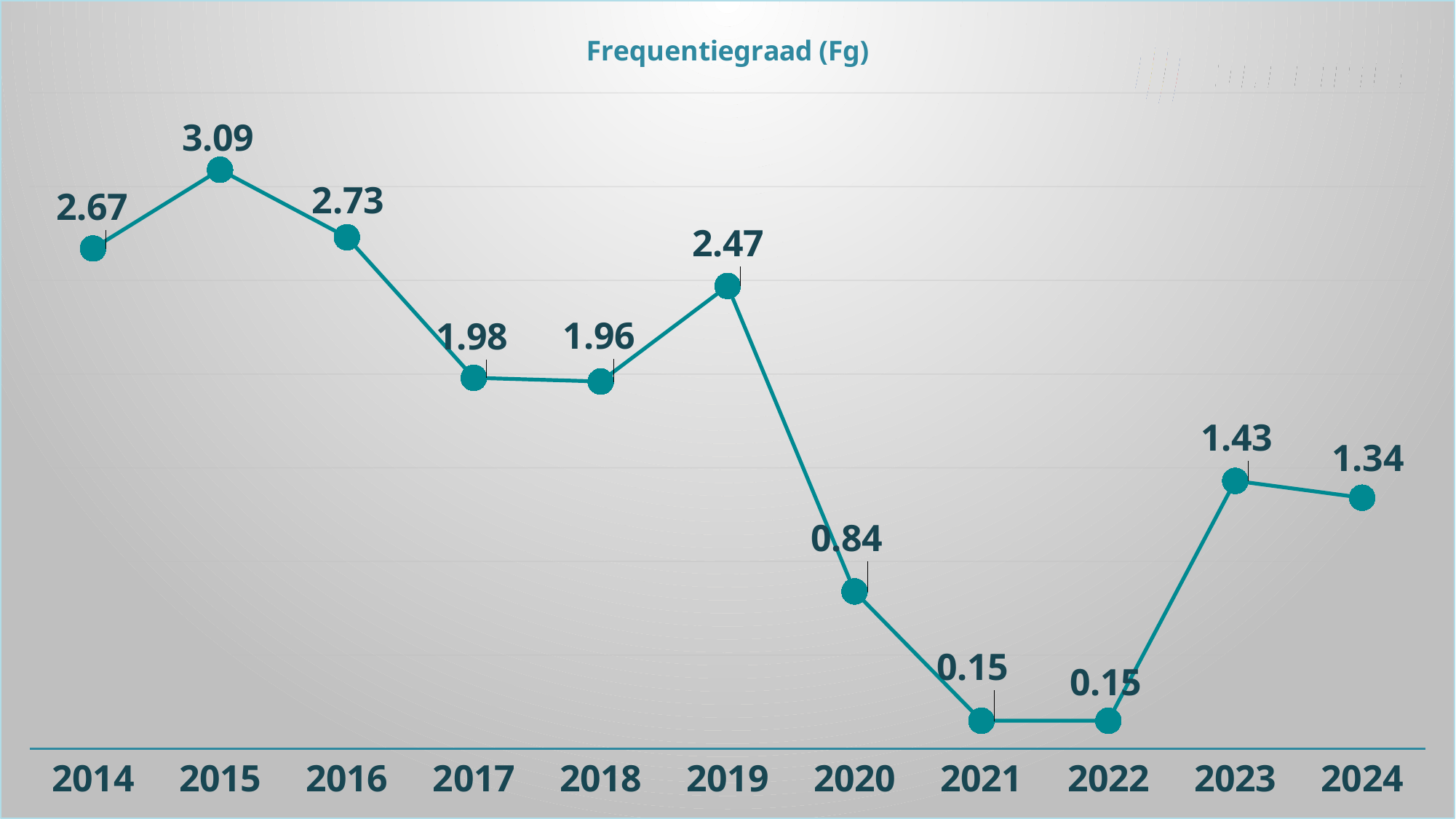
What is the value for 2024? 1.34 What is the value for 2015? 3.09 Which year has the highest value? 2015 What is the value for 2020? 0.84 How many years are plotted on the chart? 11 Which is larger, the value for 2014 or the value for 2016? 2016 What is the difference between the values for 2019 and 2020? 1.63 What is the difference between the values for 2015 and 2016? 0.36 What kind of chart is shown? Line chart Which is larger, the value for 2023 or the value for 2024? 2023 What is the title of the chart? Frequentiegraad (Fg) What is the lowest value shown on the chart? 0.15